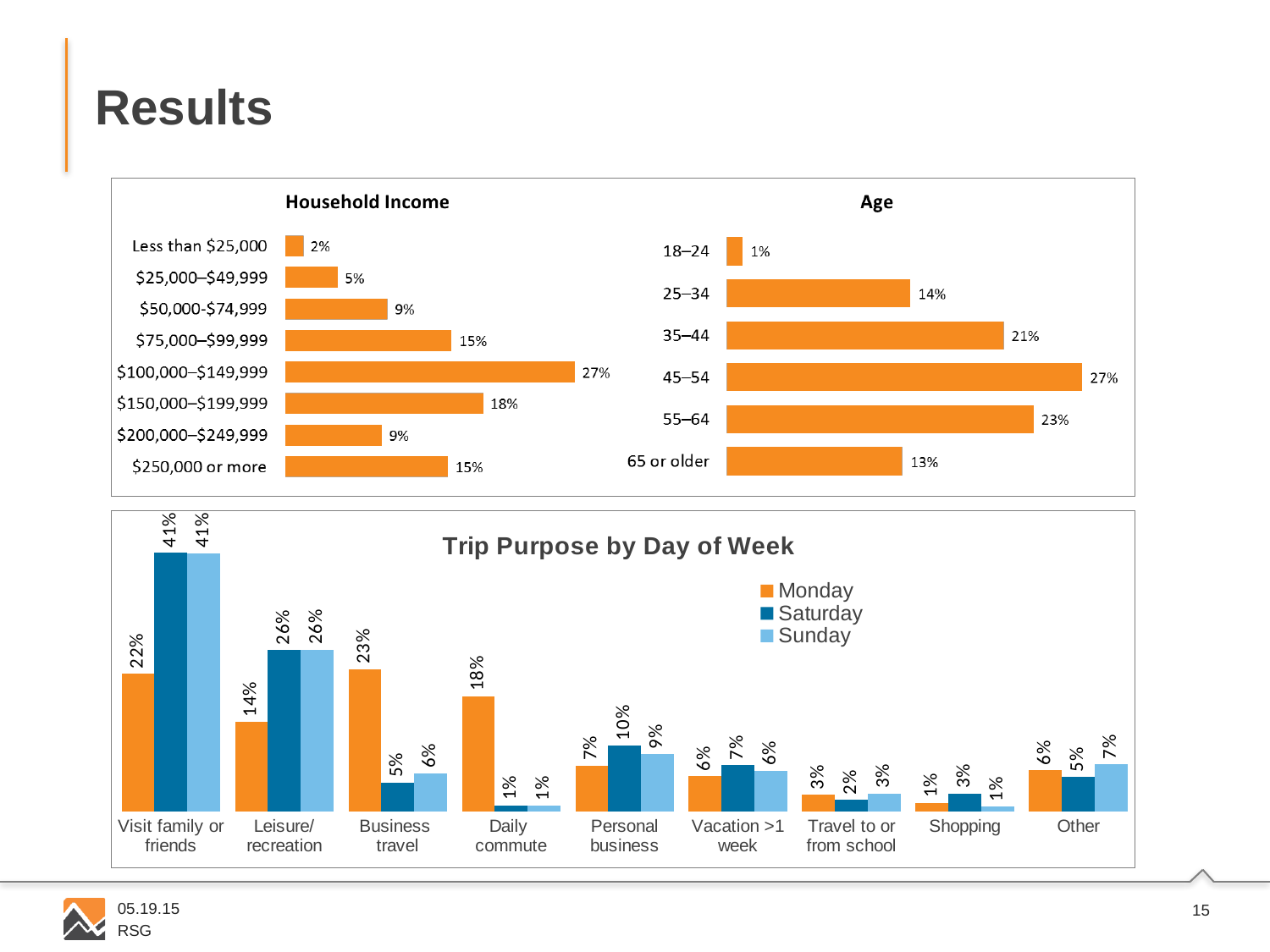
In the Household Income chart, how many income categories are shown? 8 In the Trip Purpose by Day of Week chart, what is the difference between the Saturday and Monday values for Visit family or friends? 19% In the Age chart, which is larger, the value for 25–34 or the value for 65 or older? 25–34 In the Trip Purpose by Day of Week chart, how many series does the legend list? 3 In the Household Income chart, what percentage of respondents have a household income of $100,000–$149,999? 27% In the Household Income chart, which income category has the lowest percentage? Less than $25,000 In the Household Income chart, what is the difference between the $150,000–$199,999 value and the $75,000–$99,999 value? 3% What kind of chart is the Age chart? Bar chart In the Age chart, what percentage of respondents are aged 55–64? 23% In the Trip Purpose by Day of Week chart, which trip purpose has the highest Sunday value? Visit family or friends In the Age chart, which age group has the highest percentage? 45–54 In the Trip Purpose by Day of Week chart, what is the Monday value for Business travel? 23%